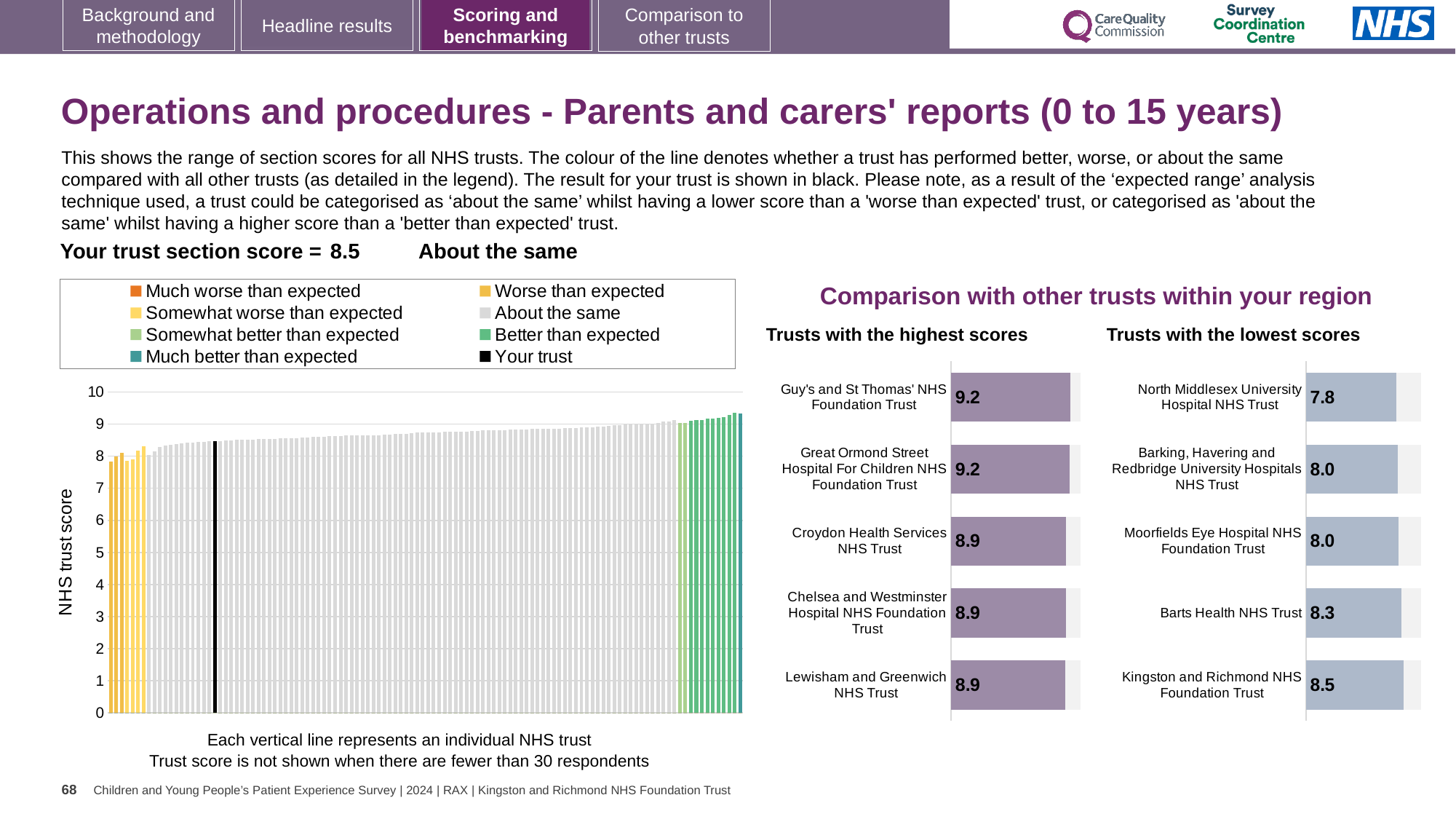
In the main 'NHS trust score' chart on the left, do the bar heights rise or fall from left to right? rise In the 'Trusts with the lowest scores' chart, what is the score for North Middlesex University Hospital NHS Trust? 7.8 How many trusts are listed in the 'Trusts with the highest scores' chart? 5 In the 'Trusts with the lowest scores' chart, what is the difference between the scores of Kingston and Richmond NHS Foundation Trust and North Middlesex University Hospital NHS Trust? 0.7 In the 'Trusts with the lowest scores' chart, which has the higher score: Barts Health NHS Trust or Moorfields Eye Hospital NHS Foundation Trust? Barts Health NHS Trust In the 'Trusts with the lowest scores' chart, which trust has the lowest score? North Middlesex University Hospital NHS Trust In the 'Trusts with the lowest scores' chart, which trust has the highest score? Kingston and Richmond NHS Foundation Trust In the main 'NHS trust score' chart on the left, is the value for the black 'Your trust' bar greater or less than 8? greater In the 'Trusts with the highest scores' chart, what is the score for Guy's and St Thomas' NHS Foundation Trust? 9.2 In the 'Trusts with the highest scores' chart, what is the difference between the scores of Guy's and St Thomas' NHS Foundation Trust and Lewisham and Greenwich NHS Trust? 0.3 In the 'Trusts with the highest scores' chart, what is the score for Croydon Health Services NHS Trust? 8.9 How many entries does the legend above the main 'NHS trust score' chart list? 8